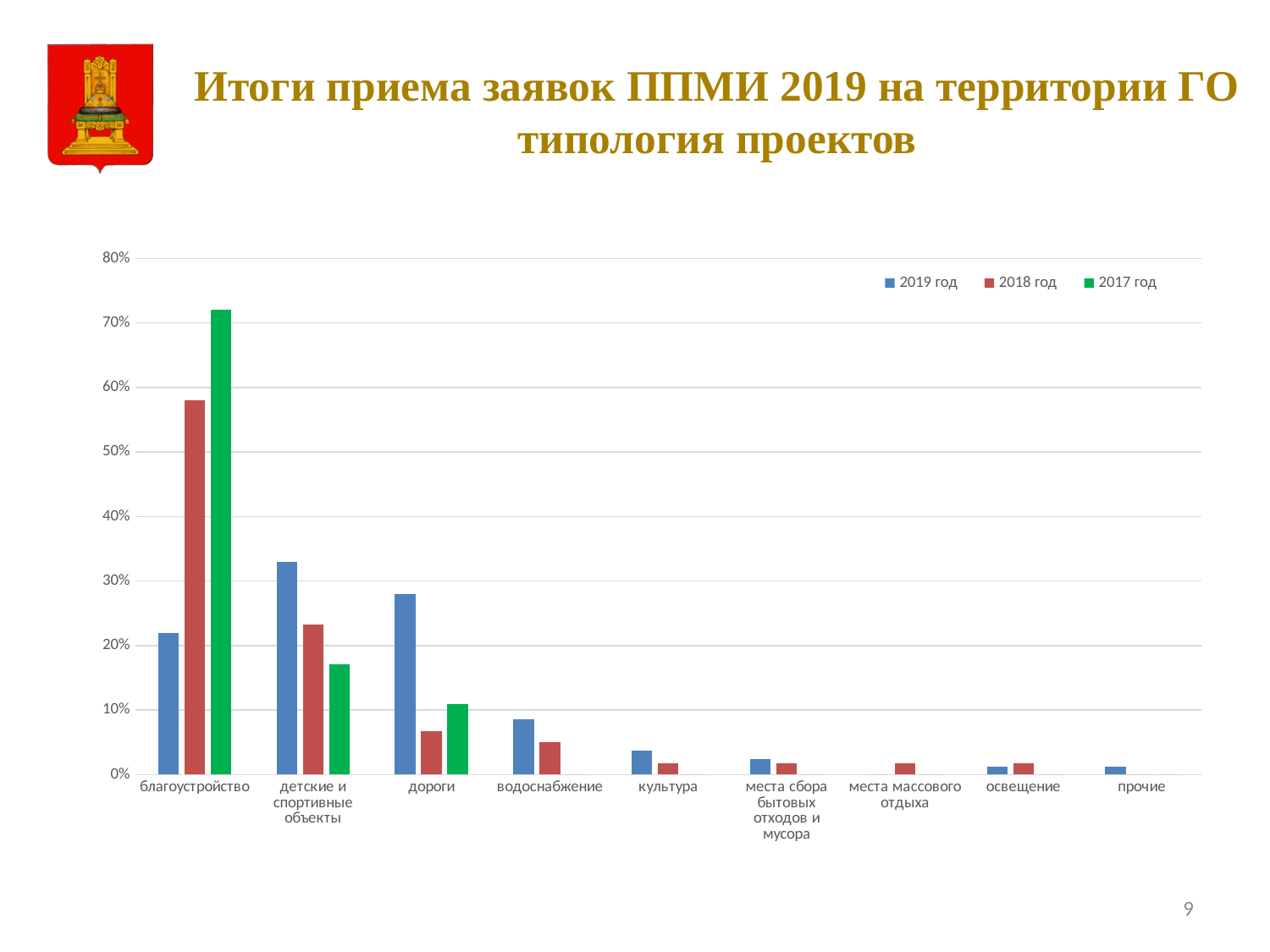
How many project categories are shown along the x axis? 9 Is the 2018 год value for благоустройство greater or less than 50%? greater Do the 2017 год values rise or fall from благоустройство to дороги along the x axis? fall For дороги, which is larger: the 2019 год value or the 2017 год value? 2019 год Which category has the highest value for the 2017 год series? благоустройство For благоустройство, which is larger: the 2019 год value or the 2018 год value? 2018 год Is the 2019 год value for дороги greater or less than 20%? greater What colour represents the 2017 год series in the legend? green Which category has the highest value for the 2019 год series? детские и спортивные объекты How many series does the legend list? 3 Is the 2017 год value for благоустройство greater or less than 60%? greater What kind of chart is shown on the slide? bar chart